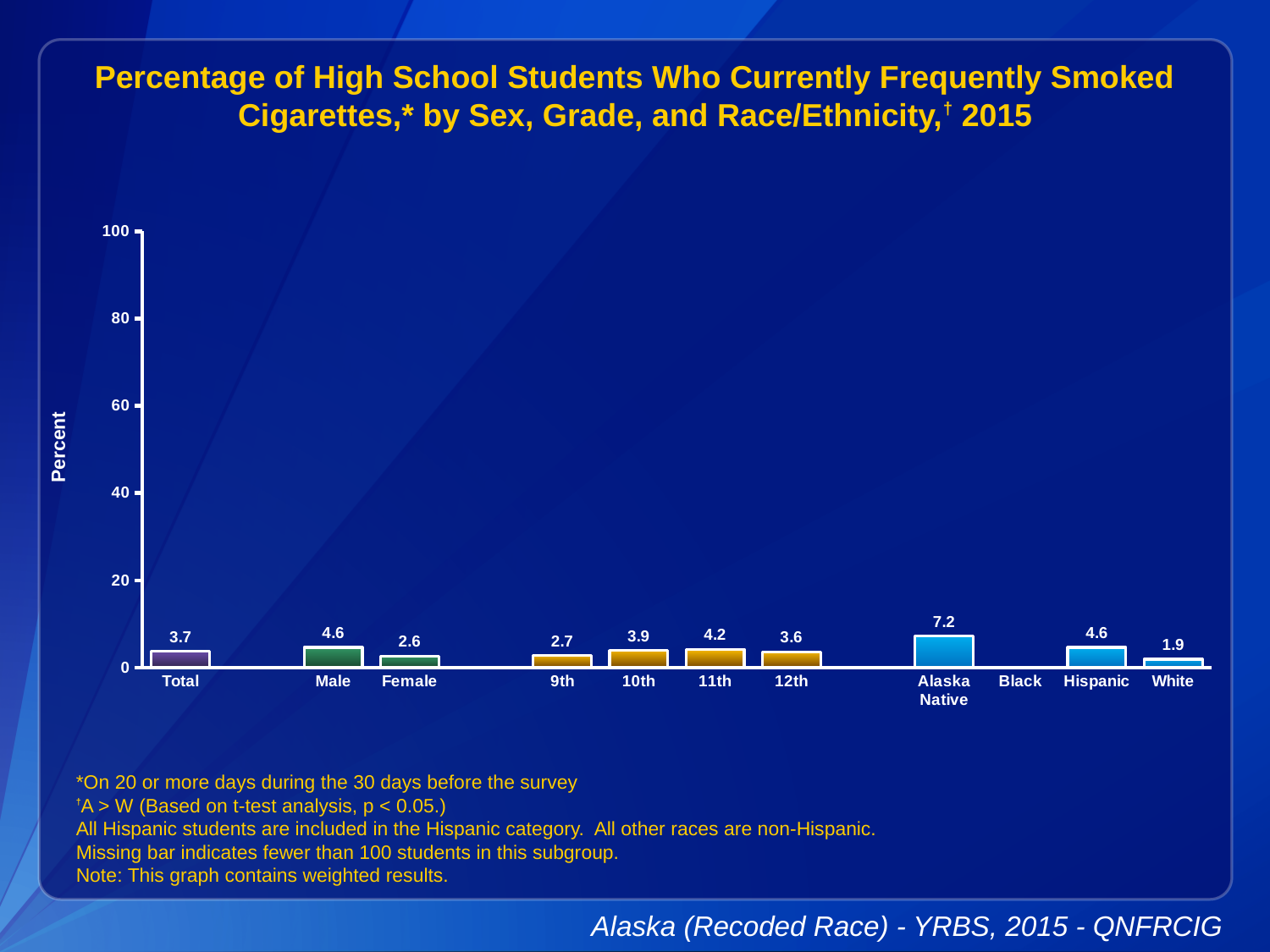
How many categories are labeled on the x axis? 12 What is the value for Alaska Native? 7.2 What kind of chart is shown? bar chart What is the value for 10th grade? 3.9 Which category has no bar shown? Black Which is larger, the value for 11th grade or 12th grade? 11th What is the value for Total? 3.7 What is the label of the y axis? Percent Which category with a bar has the lowest value? White Which category has the highest value? Alaska Native What is the difference between the Male and Female values? 2.0 Is the value for Hispanic greater or less than 20? less